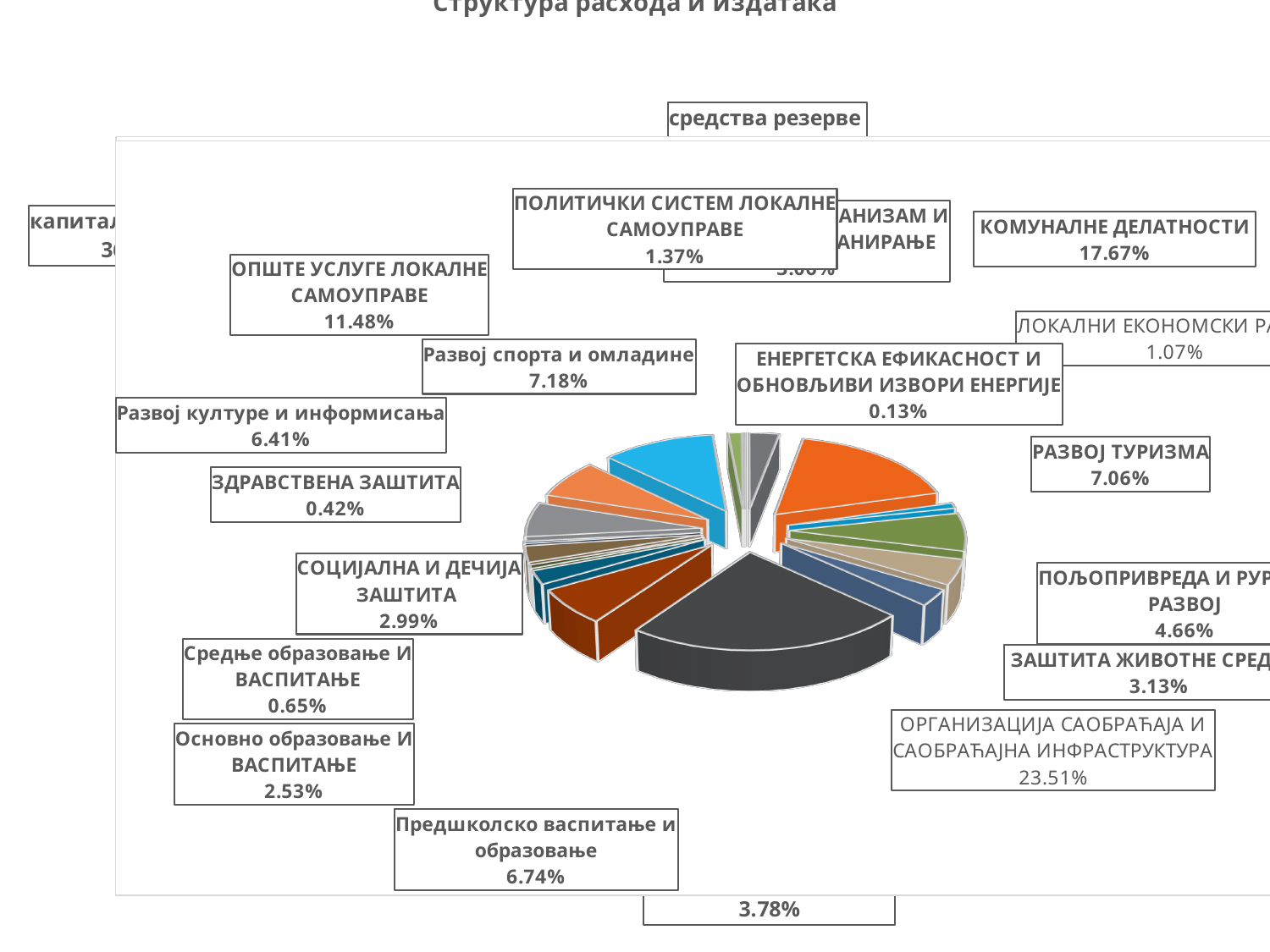
Which is larger: СОЦИЈАЛНА И ДЕЧИЈА ЗАШТИТА or Основно образовање И ВАСПИТАЊЕ? СОЦИЈАЛНА И ДЕЧИЈА ЗАШТИТА What is the difference in percentage points between КОМУНАЛНЕ ДЕЛАТНОСТИ and ОПШТЕ УСЛУГЕ ЛОКАЛНЕ САМОУПРАВЕ? 6.19% What is the value for РАЗВОЈ ТУРИЗМА? 7.06% What value is shown for Предшколско васпитање и образовање? 6.74% What percentage is given for ЗДРАВСТВЕНА ЗАШТИТА? 0.42% What is the share for ЕНЕРГЕТСКА ЕФИКАСНОСТ И ОБНОВЉИВИ ИЗВОРИ ЕНЕРГИЈЕ? 0.13% What is the difference between ОРГАНИЗАЦИЈА САОБРАЋАЈА И САОБРАЋАЈНА ИНФРАСТРУКТУРА and КОМУНАЛНЕ ДЕЛАТНОСТИ? 5.84% Which has a larger share: Развој спорта и омладине or Развој културе и информисања? Развој спорта и омладине What kind of chart is shown on the slide? pie chart What is the value shown for ОРГАНИЗАЦИЈА САОБРАЋАЈА И САОБРАЋАЈНА ИНФРАСТРУКТУРА? 23.51% What share does КОМУНАЛНЕ ДЕЛАТНОСТИ have in the pie chart? 17.67% What percentage is labelled for ОПШТЕ УСЛУГЕ ЛОКАЛНЕ САМОУПРАВЕ? 11.48%